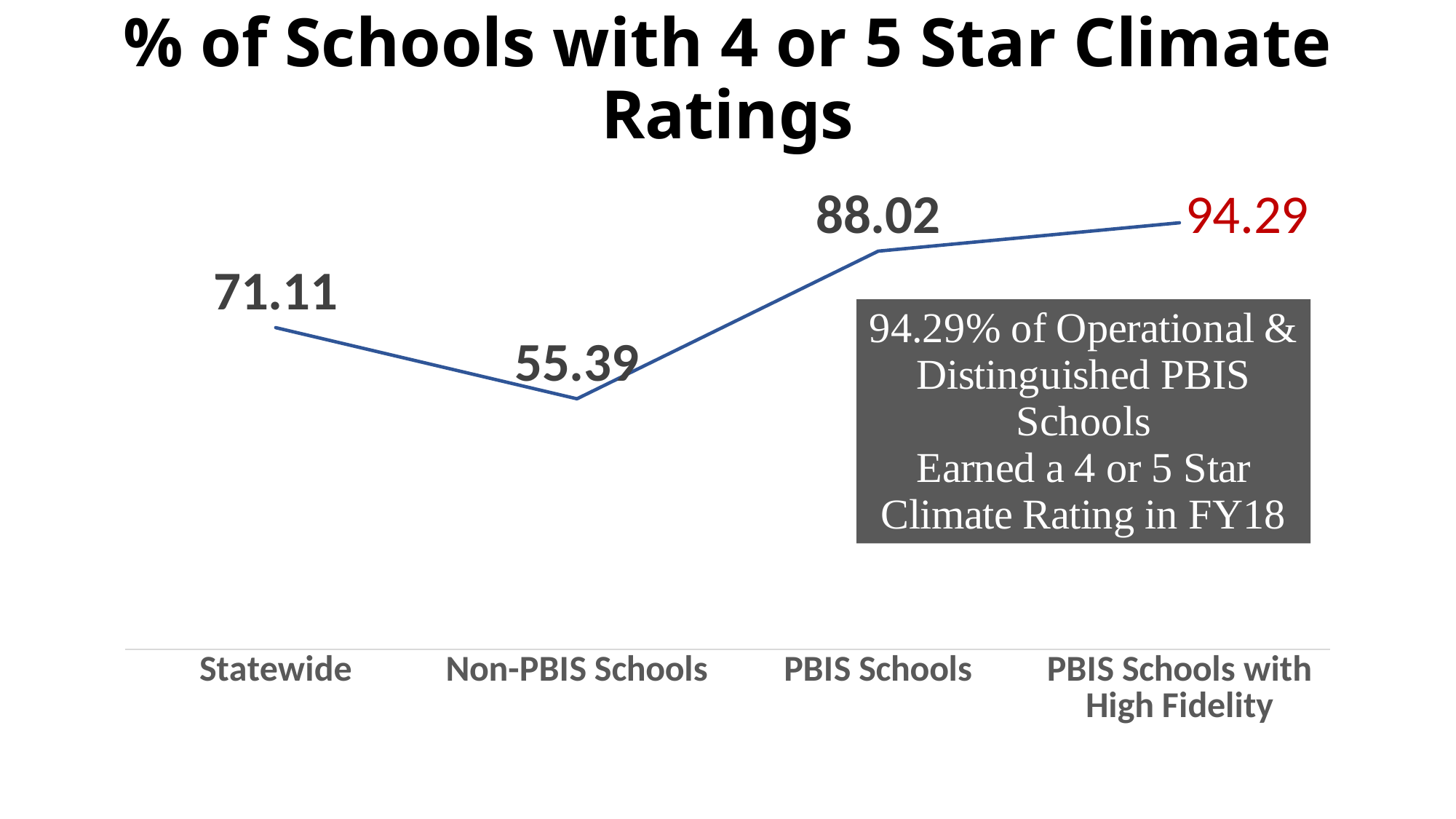
How many categories are plotted on the chart? 4 What kind of chart is shown on the slide? Line chart What is the difference between the values for PBIS Schools and Statewide? 16.91 What is the value for PBIS Schools? 88.02 Which is larger, the value for Statewide or the value for Non-PBIS Schools? Statewide What is the title of the chart? % of Schools with 4 or 5 Star Climate Ratings Which category has the highest value? PBIS Schools with High Fidelity What is the value for Statewide? 71.11 What is the value for Non-PBIS Schools? 55.39 Which category has the lowest value? Non-PBIS Schools What is the difference between the values for PBIS Schools with High Fidelity and Non-PBIS Schools? 38.90 What is the value for PBIS Schools with High Fidelity? 94.29